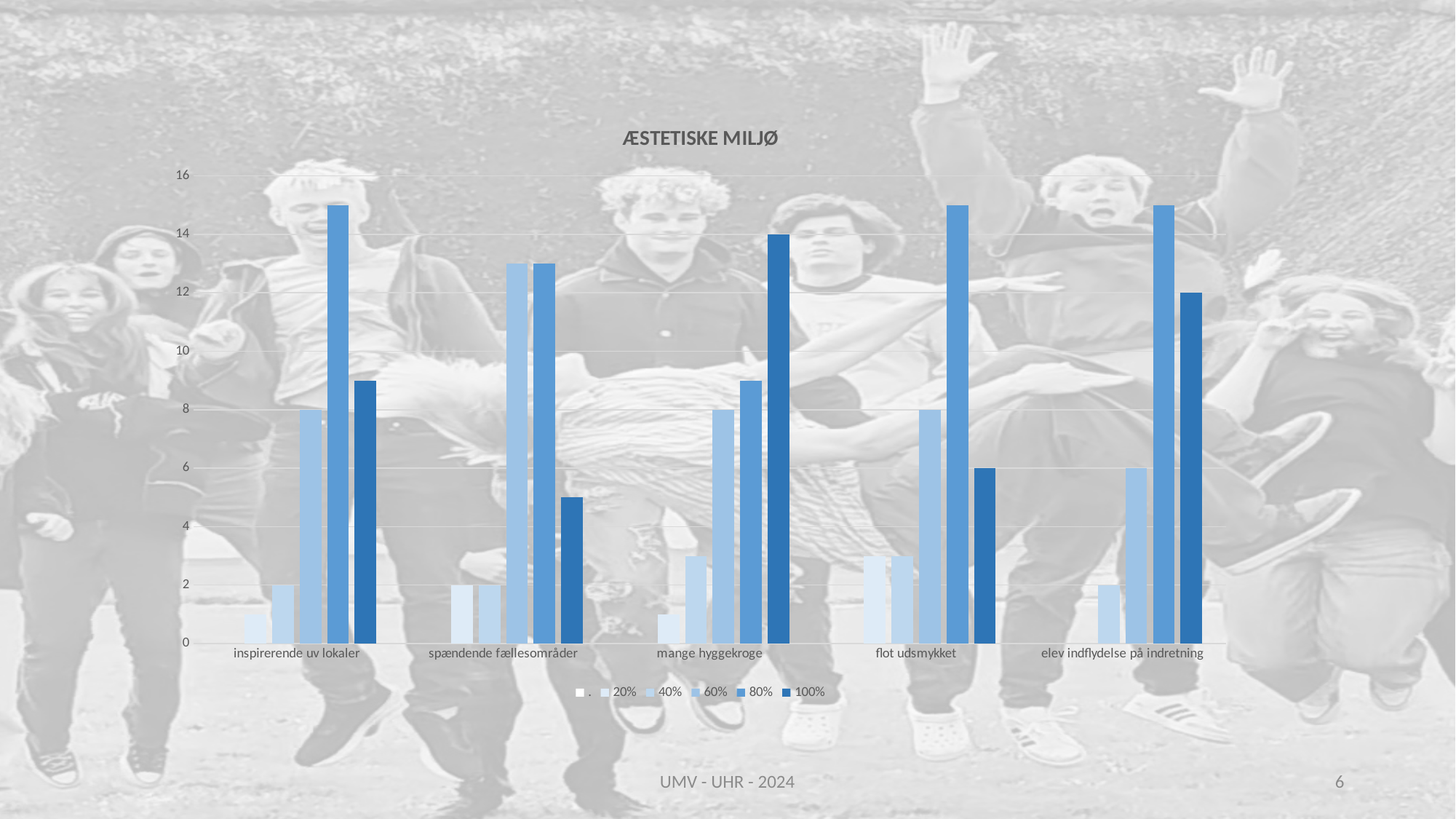
What is the value of the 100% series for 'elev indflydelse på indretning'? 12 What kind of chart is shown on the slide? bar chart Which is larger in the 100% series: 'mange hyggekroge' or 'elev indflydelse på indretning'? mange hyggekroge How many categories are shown on the x axis of the chart? 5 What is the value of the 100% series for 'mange hyggekroge'? 14 What is the difference between the 100% series values for 'mange hyggekroge' and 'elev indflydelse på indretning'? 2 Is the value of the 100% series for 'spændende fællesområder' greater or less than 6? less What is the title of the chart? ÆSTETISKE MILJØ Is the value of the 80% series for 'inspirerende uv lokaler' greater or less than 14? greater How many series does the legend list? 6 What is the value of the 100% series for 'flot udsmykket'? 6 Which category has the highest value in the 100% series? mange hyggekroge